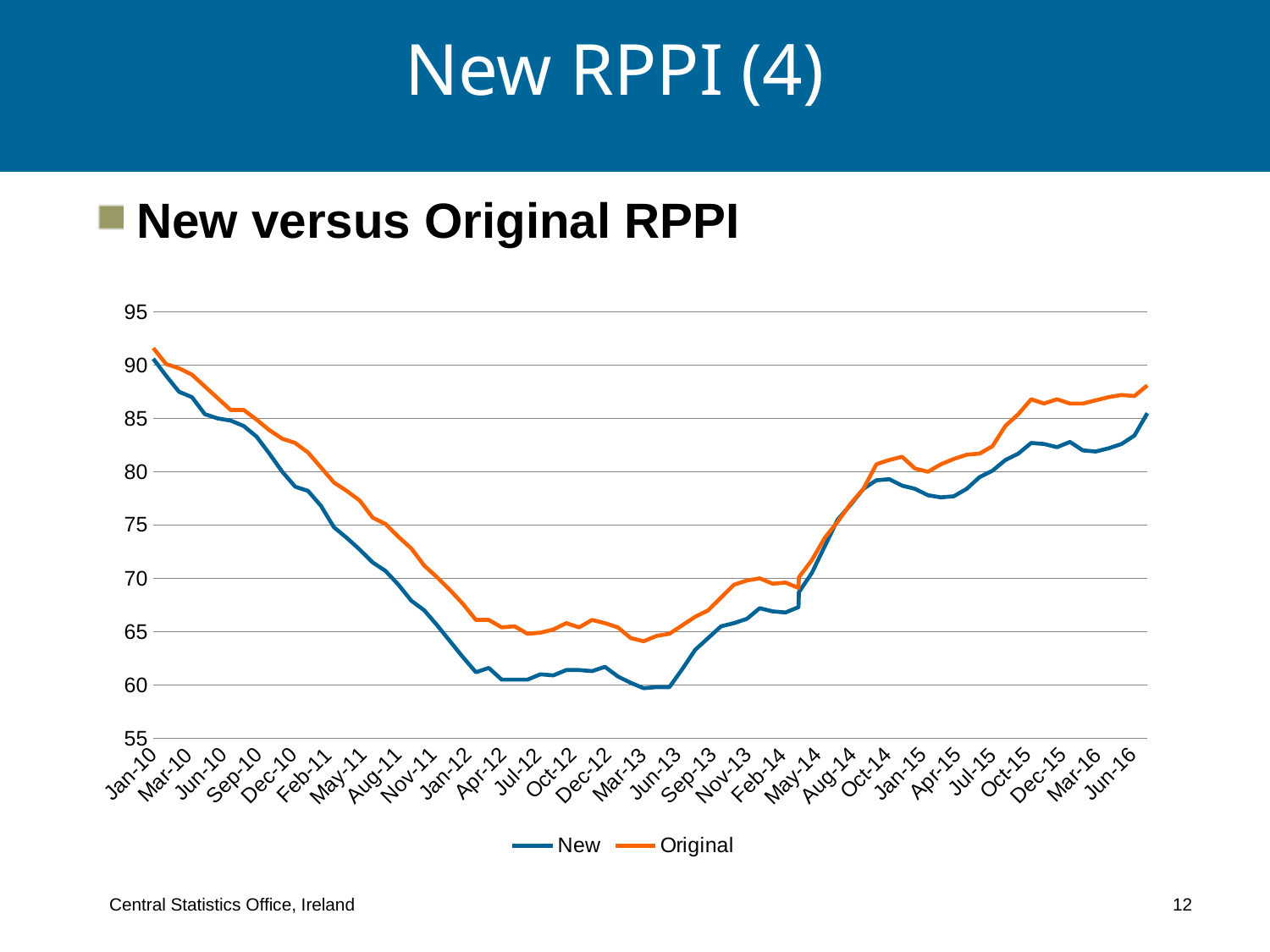
Is the value of the New series at Jan-12 greater or less than 65? less Which series is drawn in orange? Original How many series does the legend list? 2 Do the values of the New series rise or fall from Jan-10 to Mar-13? fall At Jun-16, which series has the higher value, New or Original? Original What kind of chart is shown on the slide? line chart Is the value of the Original series at Jun-16 greater or less than 85? greater At which x-axis point does the Original series reach its highest value? Jan-10 Is the value of the Original series at Jan-10 greater or less than 90? greater What are the two series named in the legend? New and Original At Mar-13, which series has the higher value, New or Original? Original